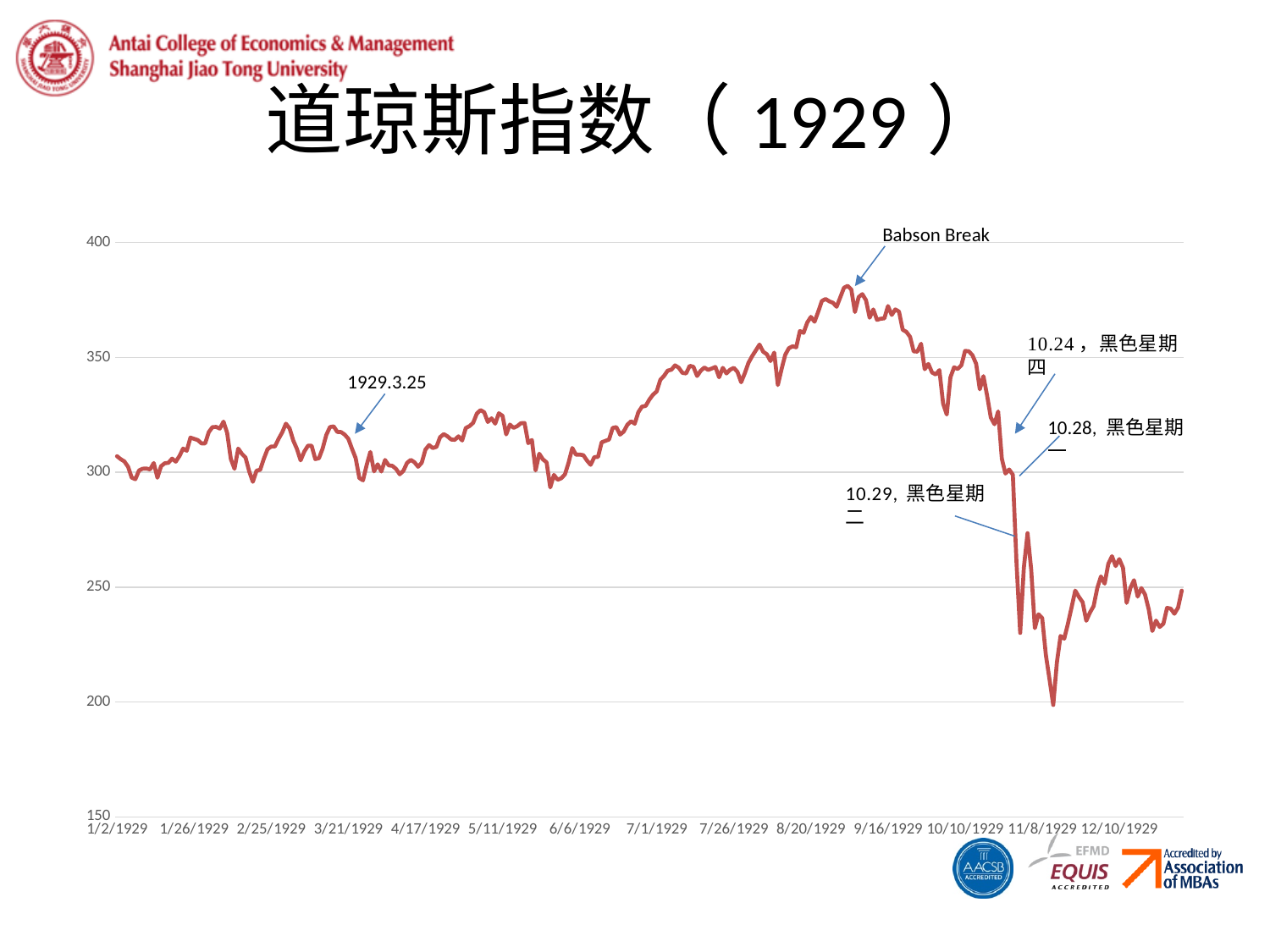
Does the index rise or fall between the Babson Break and the point labelled 10.29, 黑色星期二? fall Is the index higher at the Babson Break or at the point labelled 10.29, 黑色星期二? Babson Break Which annotation marks the peak of the line in the chart? Babson Break Does the index rise or fall overall from 1/2/1929 to the Babson Break? rise Is the lowest value of the index in November 1929 greater or less than 250? less Is the value of the index at the point labelled 10.29, 黑色星期二 greater or less than 300? less What kind of chart is shown on the slide? line chart Is the value of the index at the end of the series (around 12/10/1929) greater or less than 300? less What is the title of the chart on the slide? 道琼斯指数（1929）